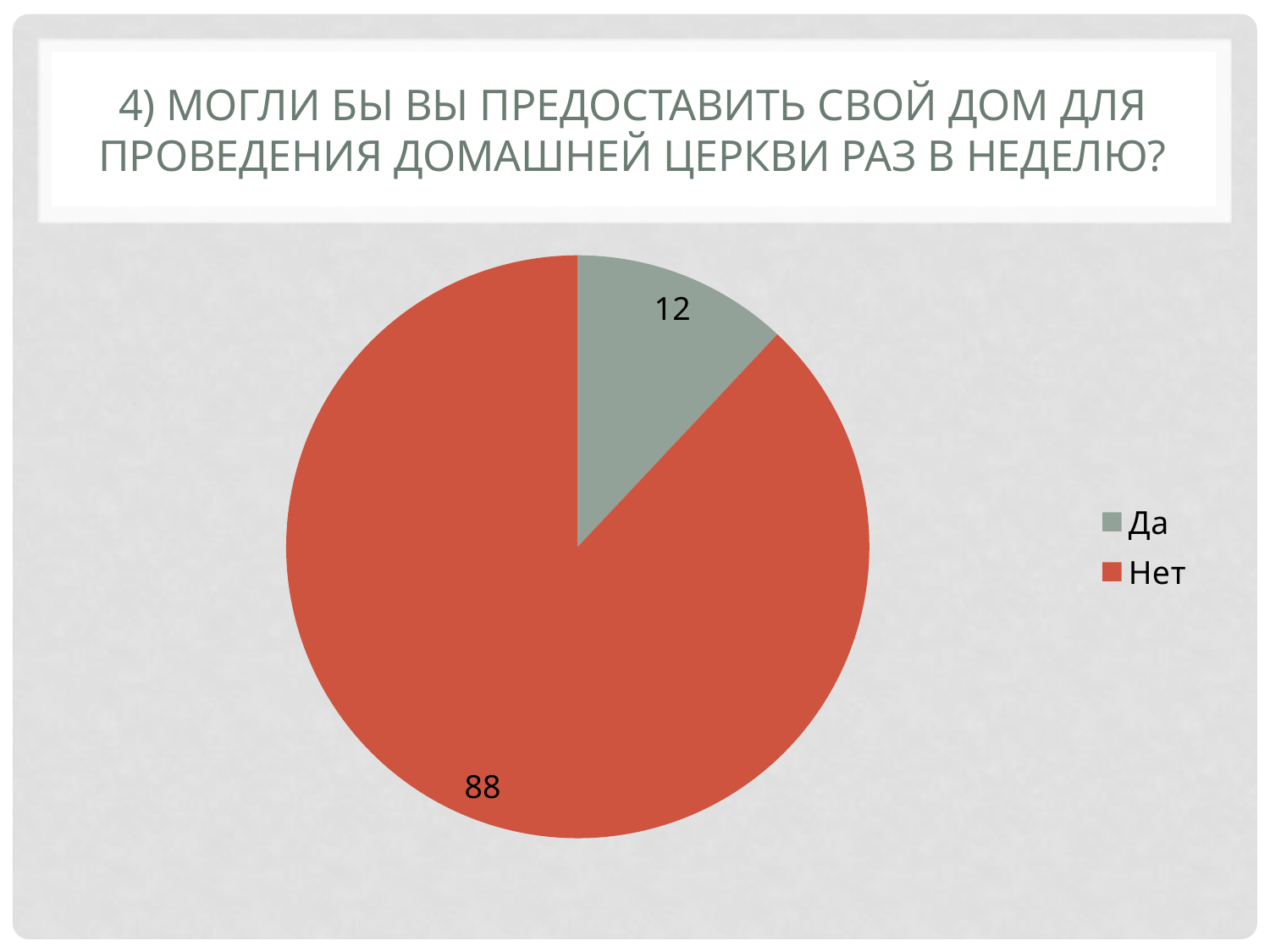
How many entries does the legend list? 2 What is the difference between the values for Нет and Да? 76 Which category has the smallest slice? Да What is the value for Да? 12 What is the total of the two slice values? 100 What type of chart is shown on the slide? pie chart Which category has the largest slice? Нет Which is larger, the value for Да or the value for Нет? Нет What colour is the Нет slice? red How many slices does the pie chart have? 2 What share of the pie does the Да slice represent? 12% What is the value for Нет? 88